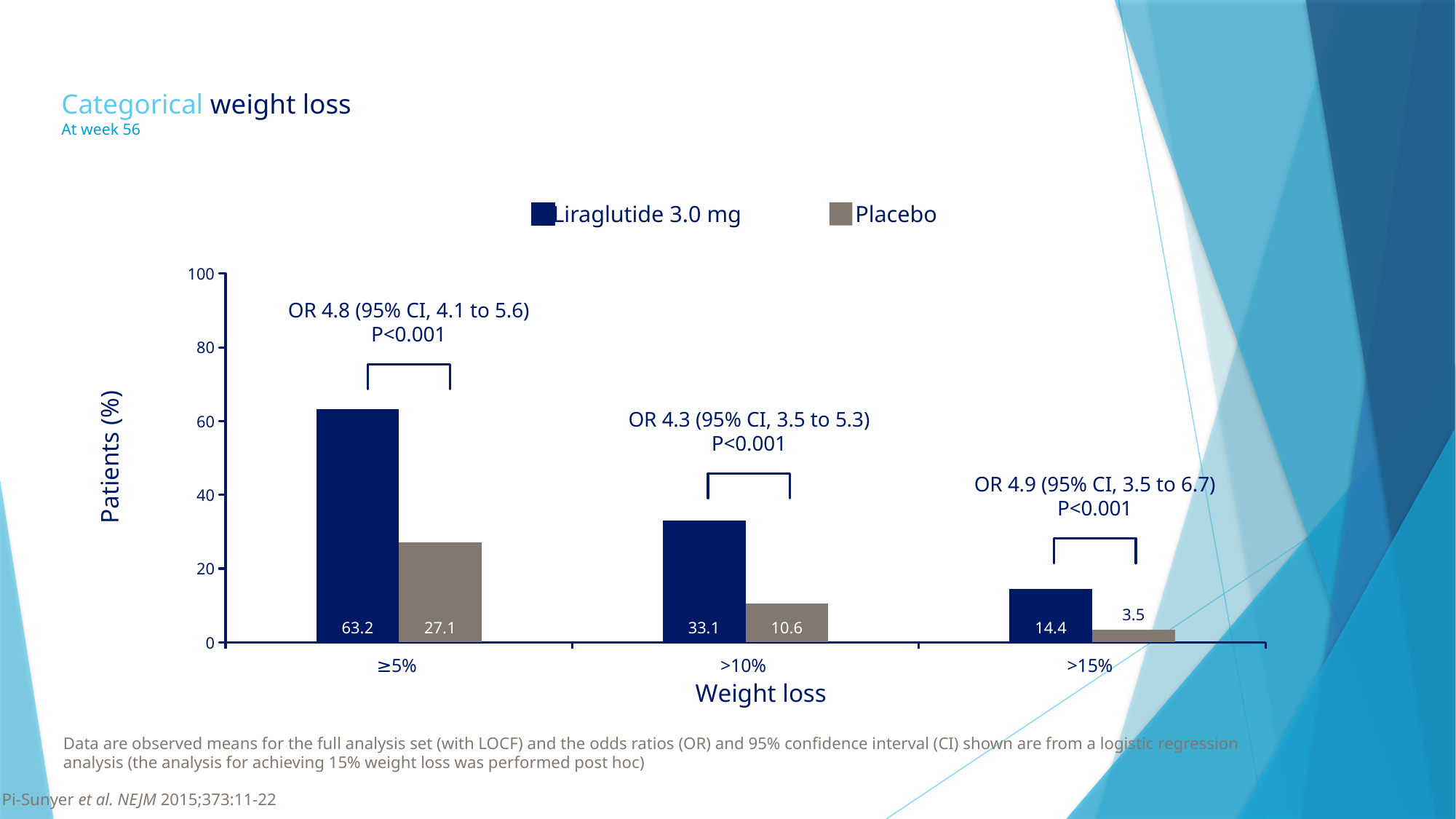
How many weight loss categories are shown on the x axis? 3 What is the value for Liraglutide 3.0 mg in the >15% weight loss category? 14.4 What kind of chart is shown on the slide? Bar chart What percentage of patients on Liraglutide 3.0 mg achieved ≥5% weight loss? 63.2 Is the value for Liraglutide 3.0 mg at ≥5% weight loss greater or less than 60? greater Which series has the larger value in the >10% weight loss category? Liraglutide 3.0 mg Which weight loss category has the highest value for Liraglutide 3.0 mg? ≥5% How many series does the legend list? 2 What is the value for Placebo in the >15% weight loss category? 3.5 What is the difference between Liraglutide 3.0 mg and Placebo in the ≥5% weight loss category? 36.1 Which weight loss category has the lowest value for Placebo? >15% What percentage of Placebo patients achieved >10% weight loss? 10.6